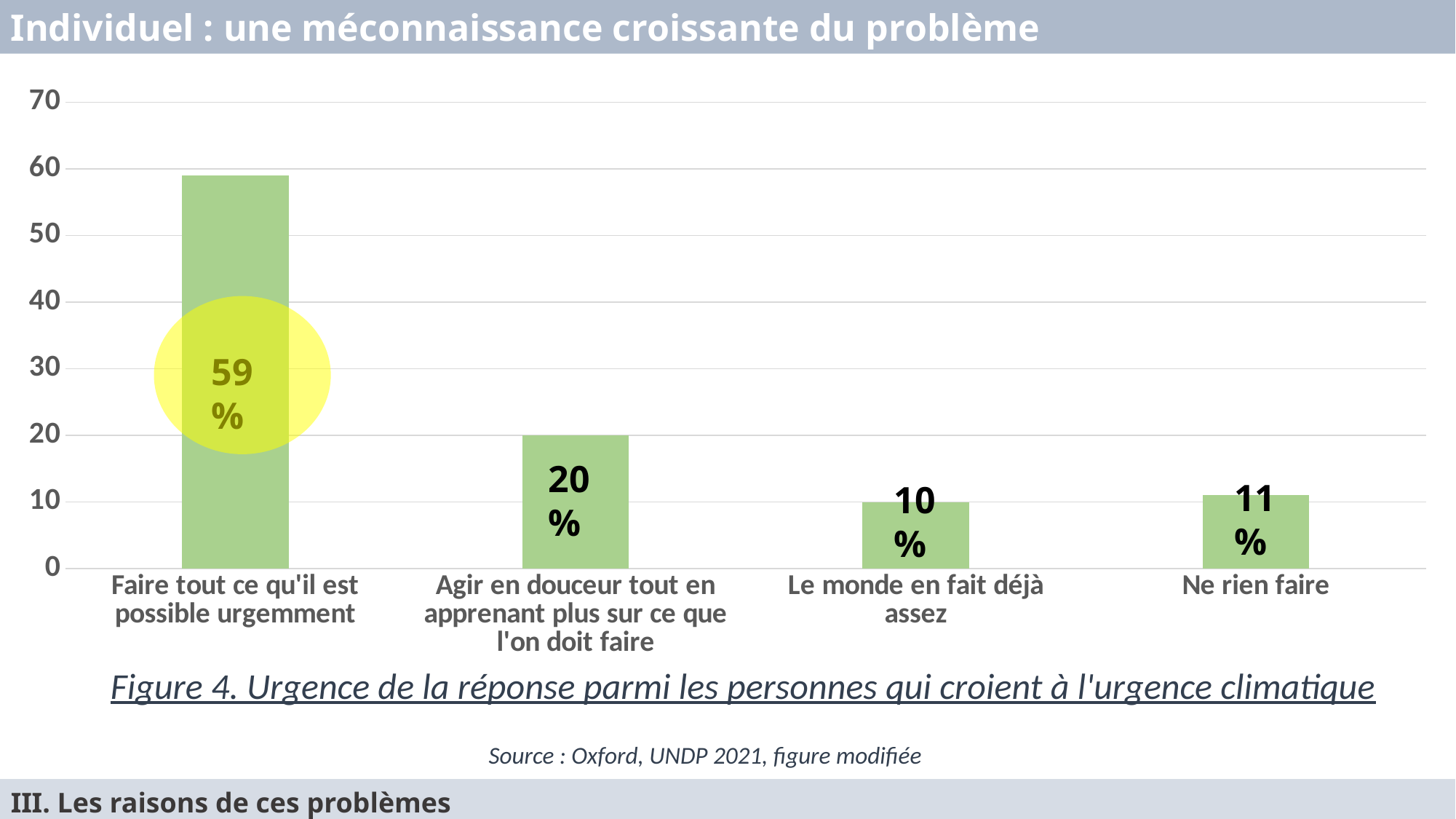
Which category has the lowest value? Le monde en fait déjà assez Which category has the highest value? Faire tout ce qu'il est possible urgemment Is the value for "Agir en douceur tout en apprenant plus sur ce que l'on doit faire" greater or less than 30? less What is the difference between the values for "Faire tout ce qu'il est possible urgemment" and "Agir en douceur tout en apprenant plus sur ce que l'on doit faire"? 39% What is the figure caption below the chart? Figure 4. Urgence de la réponse parmi les personnes qui croient à l'urgence climatique What kind of chart is shown on the slide? Bar chart Which is larger: the value for "Ne rien faire" or the value for "Le monde en fait déjà assez"? Ne rien faire What is the value for "Le monde en fait déjà assez"? 10% What is the value for "Ne rien faire"? 11% What is the value for "Agir en douceur tout en apprenant plus sur ce que l'on doit faire"? 20% How many categories are shown in the chart? 4 What is the value for "Faire tout ce qu'il est possible urgemment"? 59%